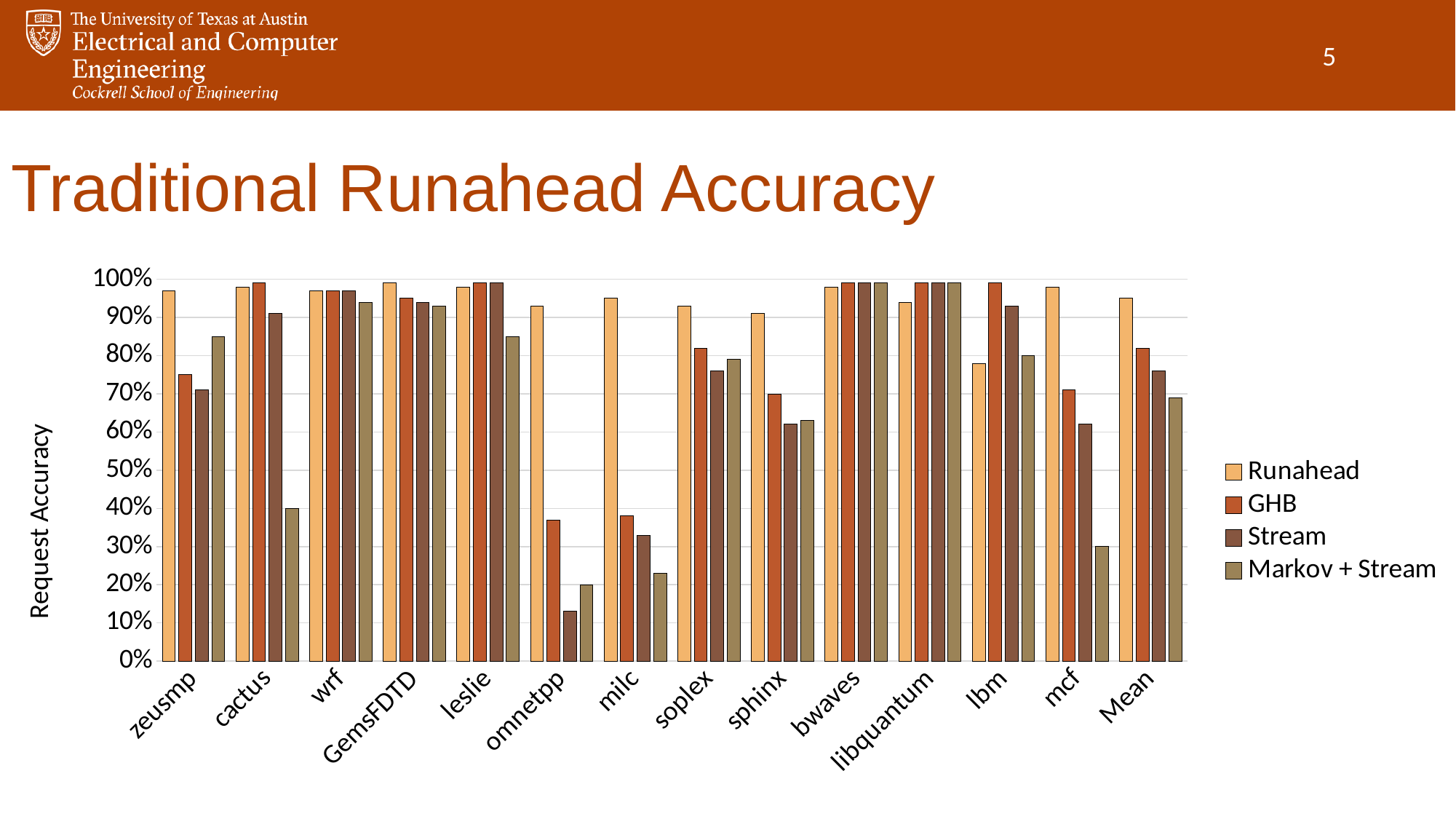
How many series does the legend list? 4 Is the GHB value for zeusmp greater or less than 70%? greater How many categories are shown along the x axis? 14 What is the label of the y axis? Request Accuracy Is the Runahead value for Mean greater or less than 90%? greater Which category has the lowest Stream value? omnetpp Is the Markov + Stream value for milc greater or less than 30%? less Which series is listed last in the legend? Markov + Stream What kind of chart is shown on the slide? bar chart Which category has the lowest Runahead value? lbm For mcf, which series has the lowest value? Markov + Stream